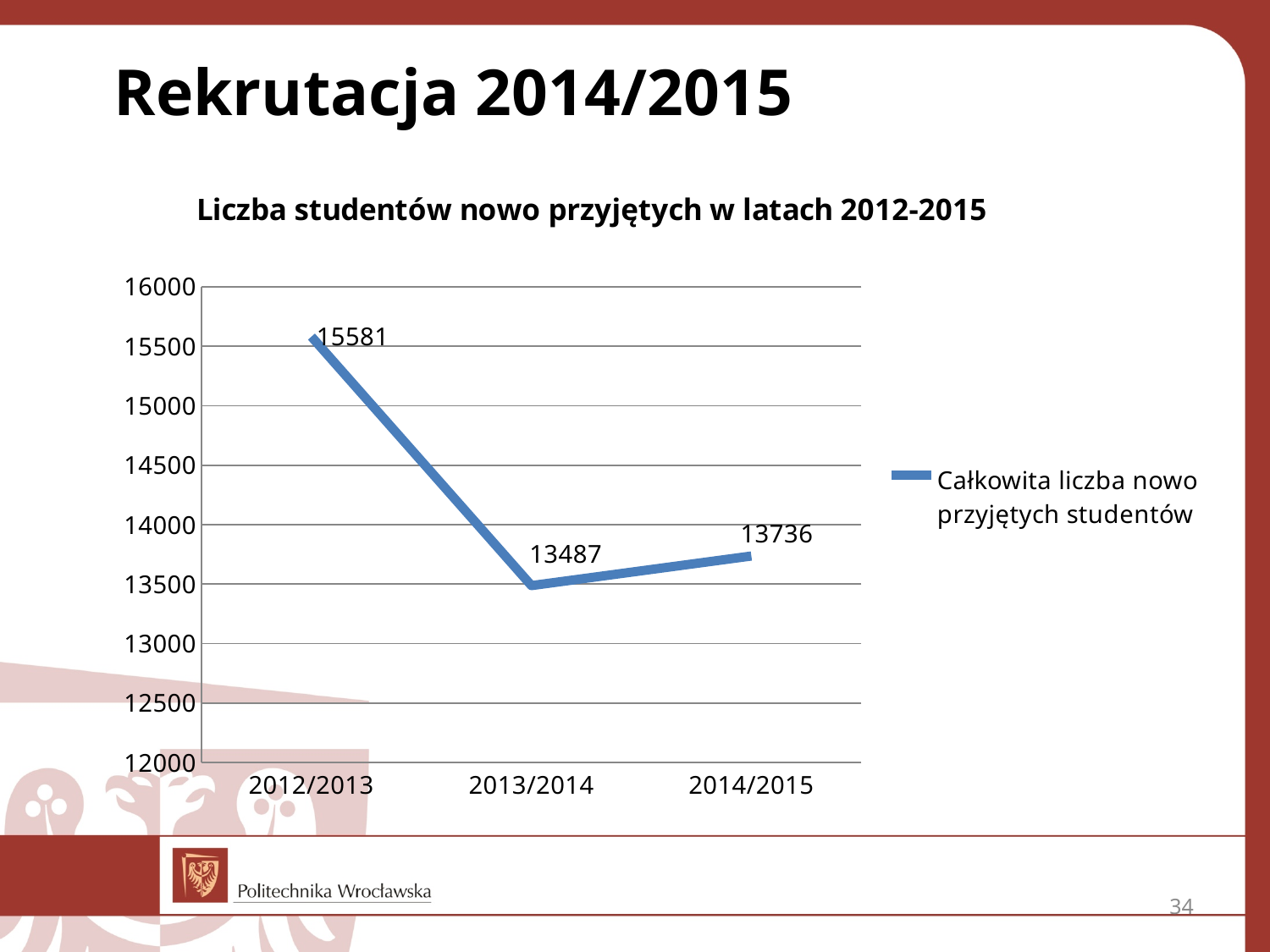
What is the difference between the number of newly admitted students in 2014/2015 and 2013/2014? 249 What is the number of newly admitted students for 2013/2014? 13487 What is the difference between the number of newly admitted students in 2012/2013 and 2013/2014? 2094 What is the title of the chart? Liczba studentów nowo przyjętych w latach 2012-2015 What is the number of newly admitted students for 2012/2013? 15581 Which academic year has the highest number of newly admitted students? 2012/2013 How many academic years are shown on the x axis? 3 Which year has more newly admitted students, 2013/2014 or 2014/2015? 2014/2015 Is the value for 2014/2015 greater or less than 14000? less What is the number of newly admitted students for 2014/2015? 13736 Which academic year has the lowest number of newly admitted students? 2013/2014 What kind of chart is shown on the slide? line chart